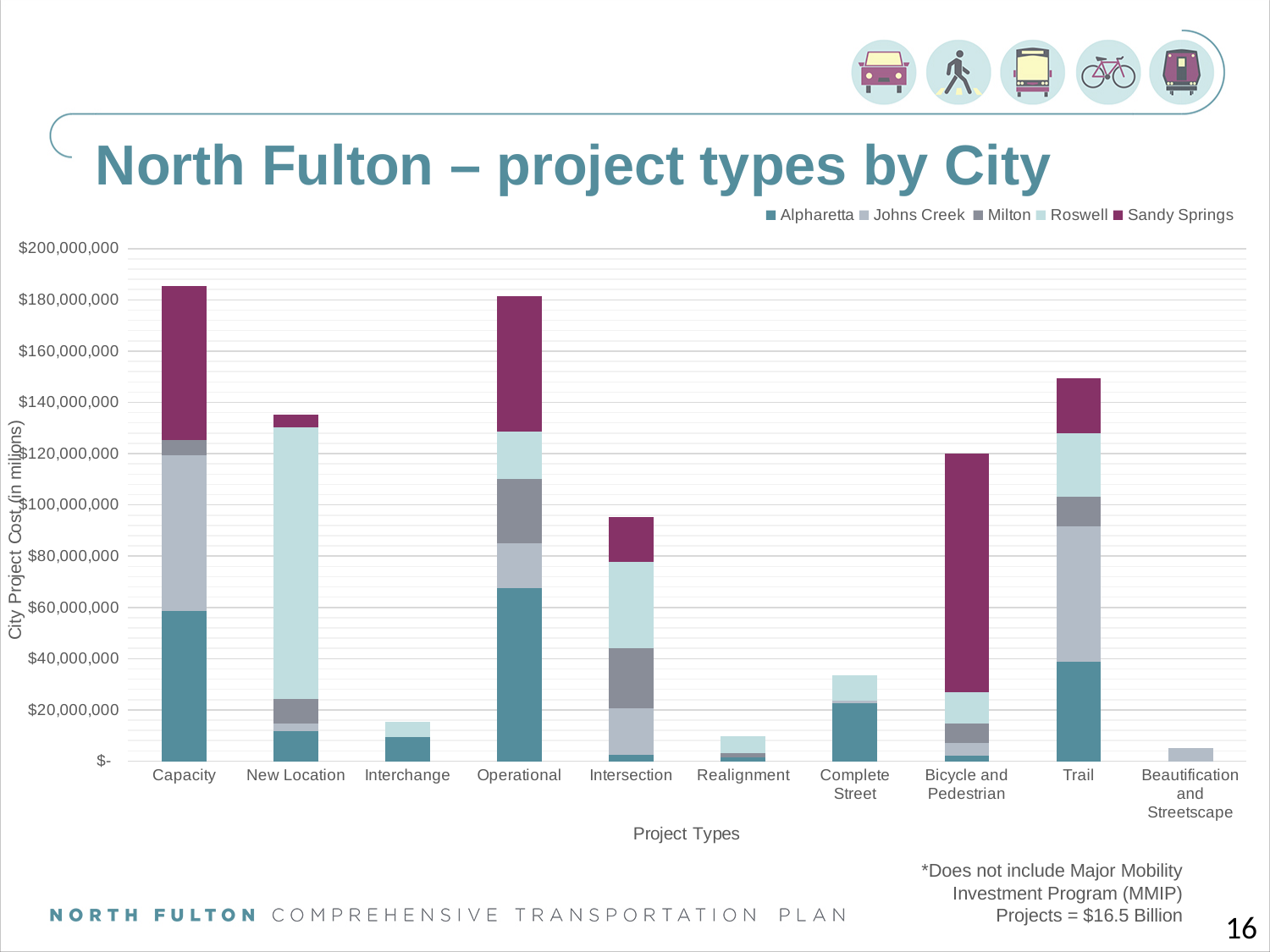
Which has the larger total city project cost, New Location or Intersection? New Location What kind of chart is shown on the slide? Stacked bar chart Is the total city project cost for Bicycle and Pedestrian greater or less than $140,000,000? less What is the label on the y axis of the chart? City Project Cost (in millions) Which has the larger total city project cost, Trail or Bicycle and Pedestrian? Trail What is the title of the chart on the slide? North Fulton – project types by City Which project type has the lowest total city project cost? Beautification and Streetscape How many cities does the legend list? 5 Is the total city project cost for Capacity greater or less than $160,000,000? greater Is the total city project cost for Trail greater or less than $140,000,000? greater How many project types are shown along the x axis? 10